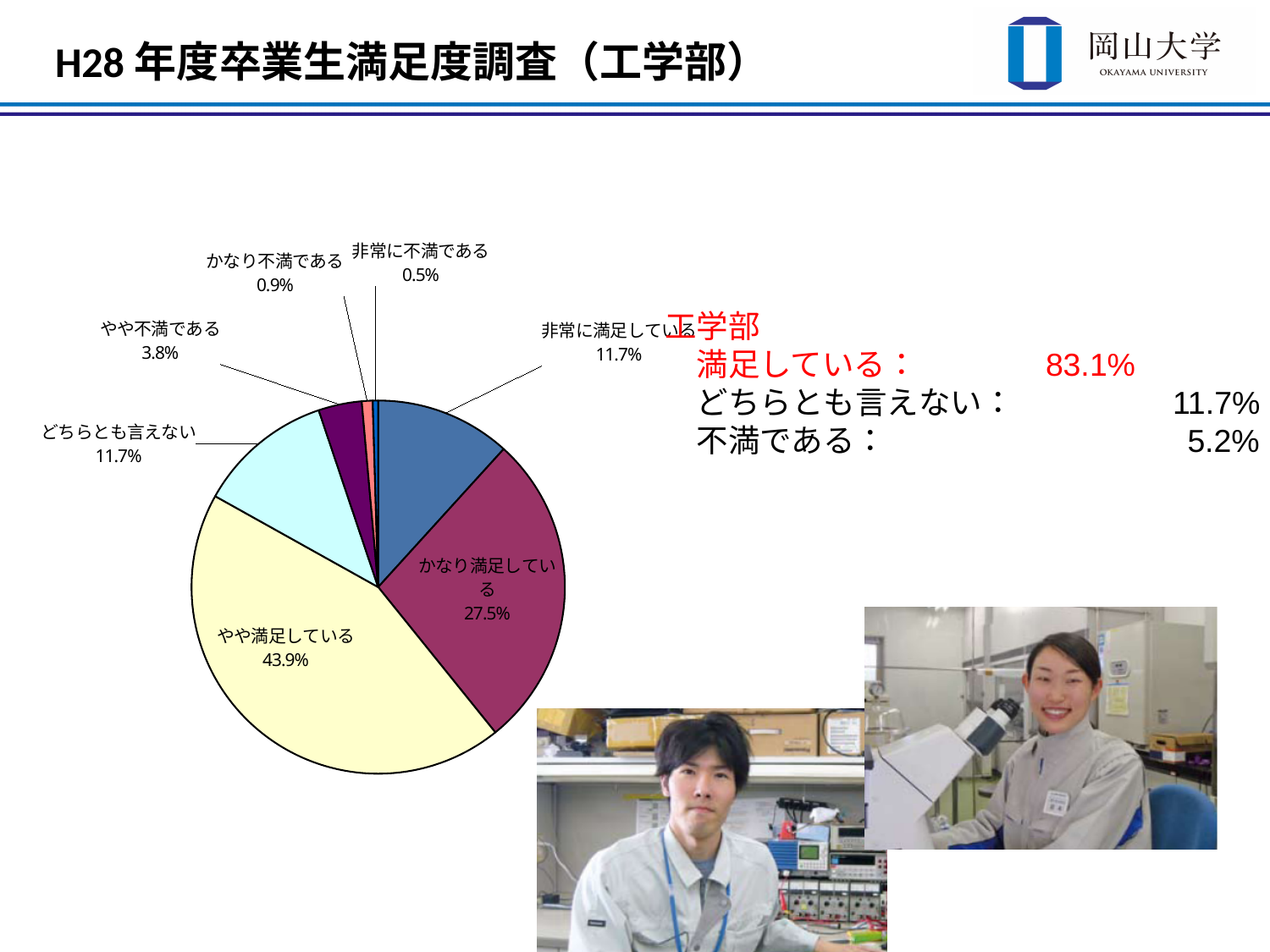
What percentage of the pie is labelled 非常に満足している? 11.7% What percentage of the pie is labelled やや満足している? 43.9% Which slice of the pie chart is the smallest? 非常に不満である What kind of chart is shown on the slide? pie chart What percentage of the pie is labelled 非常に不満である? 0.5% What percentage of the pie is labelled かなり満足している? 27.5% How many slices does the pie chart have? 7 What is the difference between the やや満足している slice and the かなり満足している slice? 16.4% Which slice of the pie chart is the largest? やや満足している What percentage of the pie is labelled やや不満である? 3.8% What is the combined share of the かなり不満である and 非常に不満である slices? 1.4% Which is larger, the どちらとも言えない slice or the やや不満である slice? どちらとも言えない